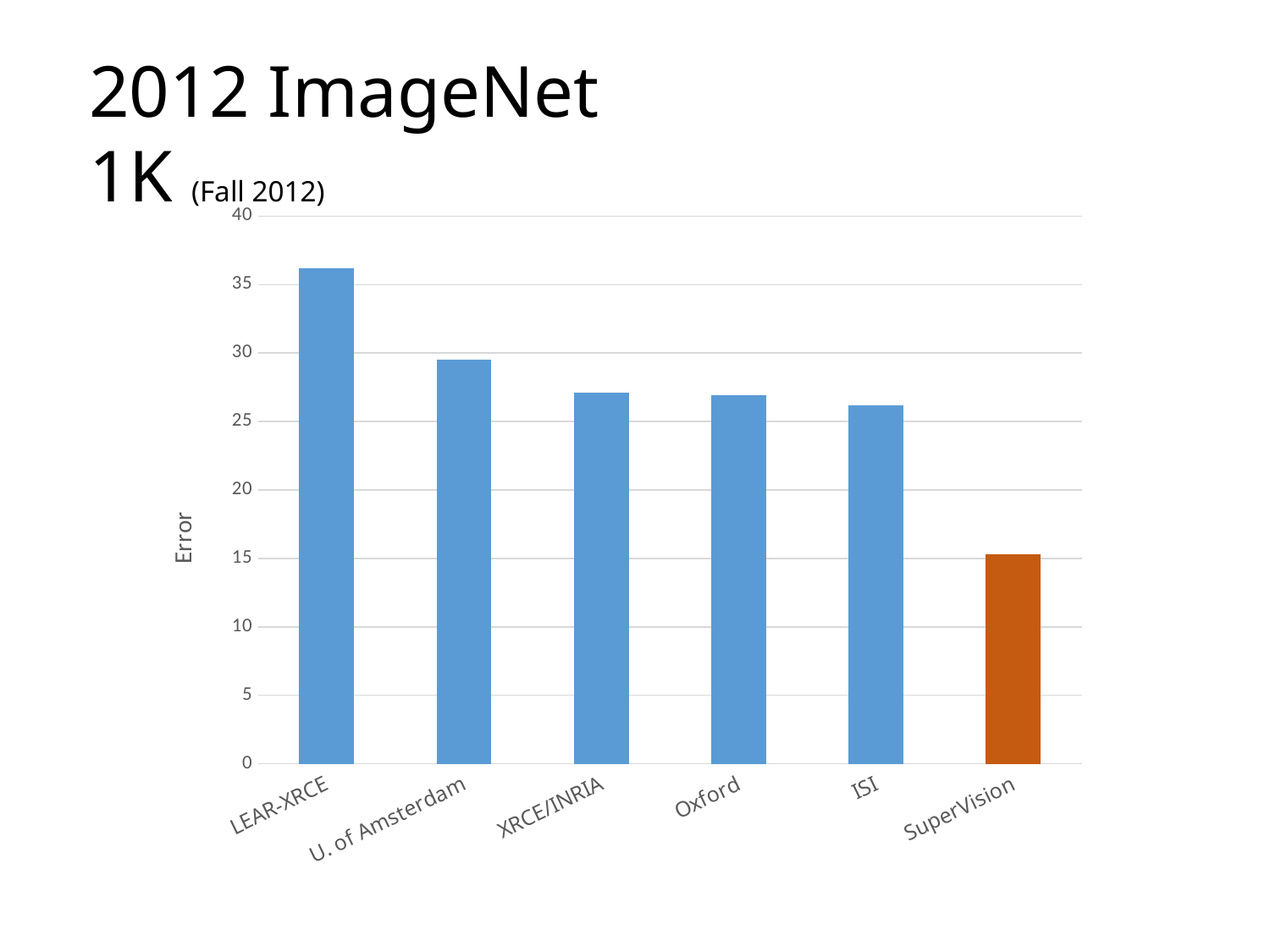
Which has the larger error, ISI or SuperVision? ISI Which team has the lowest error on the chart? SuperVision Is the error for Oxford greater or less than 30? less Which has the larger error, LEAR-XRCE or U. of Amsterdam? LEAR-XRCE Is the error for LEAR-XRCE greater or less than 35? greater Is the error for ISI greater or less than 25? greater Do the error values rise or fall moving from left to right across the chart? fall What is the label on the vertical axis of the chart? Error How many teams (categories) are plotted on the chart? 6 What kind of chart is shown on the slide? bar chart Which team has the highest error on the chart? LEAR-XRCE